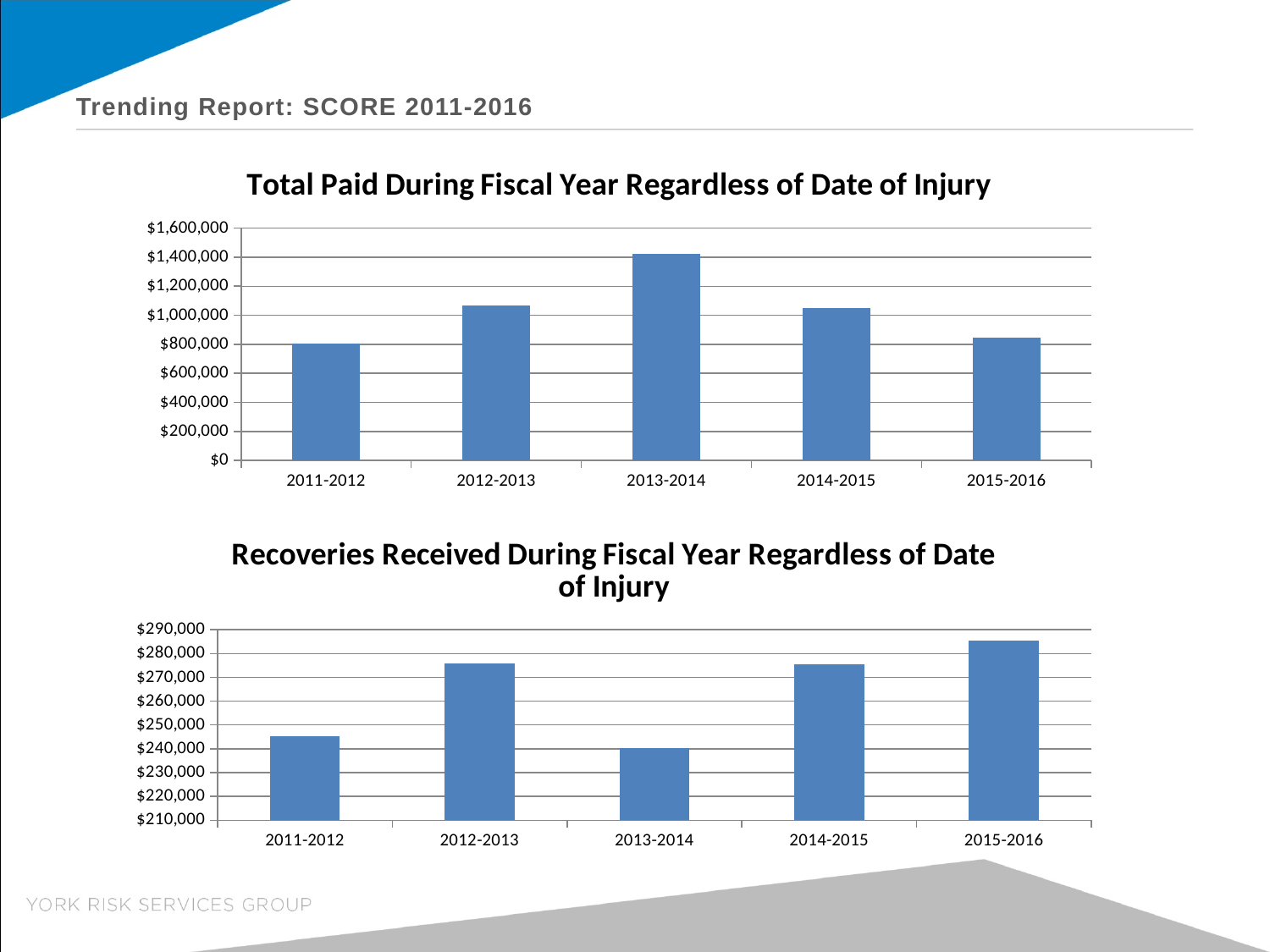
On the 'Total Paid During Fiscal Year Regardless of Date of Injury' chart, which is larger, the value for 2013-2014 or the value for 2014-2015? 2013-2014 What type of chart is the 'Recoveries Received During Fiscal Year Regardless of Date of Injury' chart? Bar chart On the 'Recoveries Received During Fiscal Year Regardless of Date of Injury' chart, is the value for 2015-2016 greater or less than $280,000? greater On the 'Total Paid During Fiscal Year Regardless of Date of Injury' chart, which fiscal year has the highest total paid? 2013-2014 On the 'Total Paid During Fiscal Year Regardless of Date of Injury' chart, is the value for 2012-2013 greater or less than $1,000,000? greater On the 'Recoveries Received During Fiscal Year Regardless of Date of Injury' chart, is the value for 2011-2012 greater or less than $250,000? less On the 'Recoveries Received During Fiscal Year Regardless of Date of Injury' chart, which is larger, the value for 2011-2012 or the value for 2012-2013? 2012-2013 On the 'Total Paid During Fiscal Year Regardless of Date of Injury' chart, how many fiscal years are shown? 5 On the 'Recoveries Received During Fiscal Year Regardless of Date of Injury' chart, which fiscal year has the highest recoveries? 2015-2016 On the 'Recoveries Received During Fiscal Year Regardless of Date of Injury' chart, which fiscal year has the lowest recoveries? 2013-2014